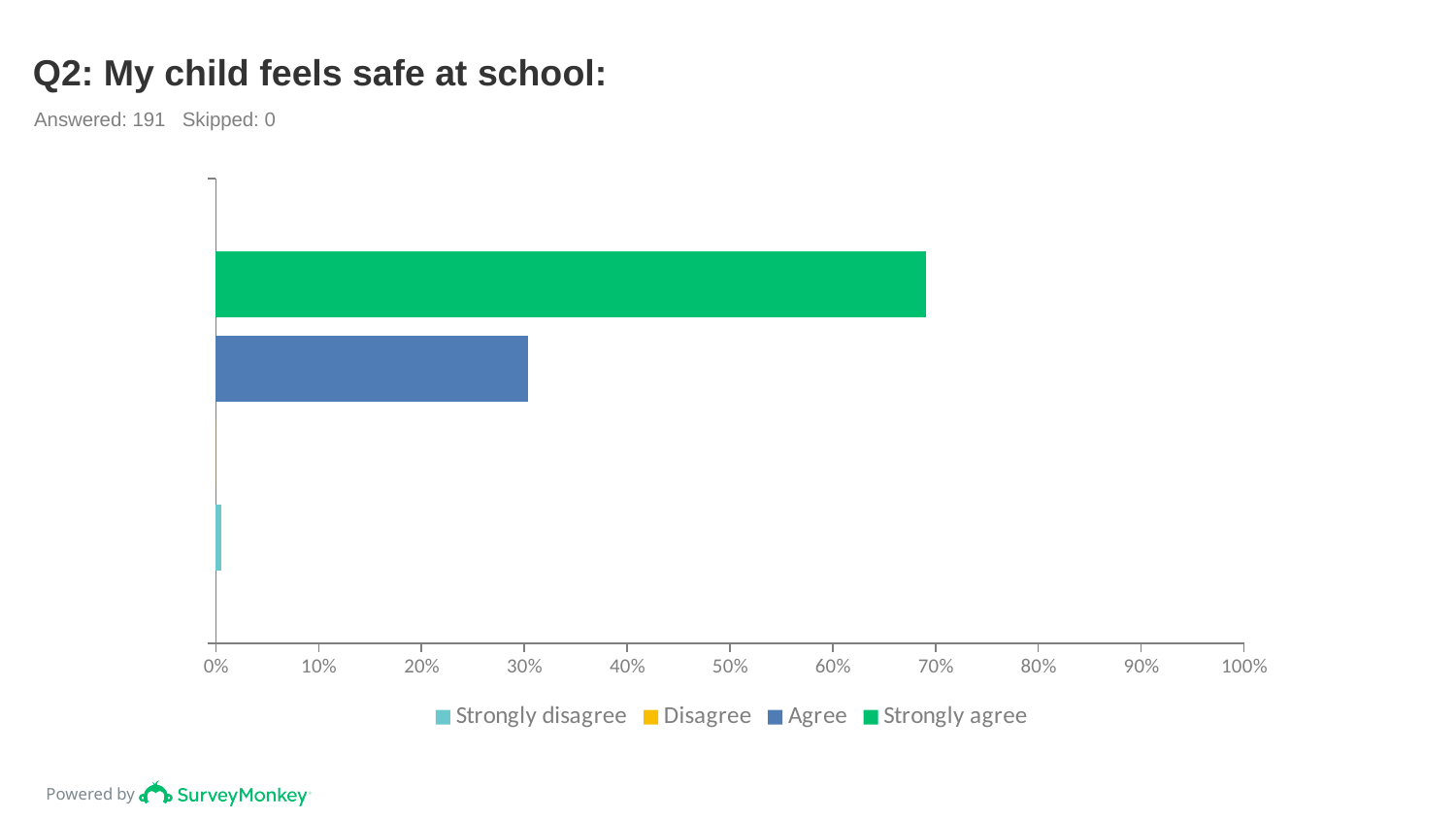
Which response option has the highest value? Strongly agree Is the value for Strongly agree greater or less than 60%? greater What kind of chart is shown on the slide? Bar chart How many series does the legend list? 4 Which is larger, the value for Agree or the value for Strongly disagree? Agree Which is larger, the value for Strongly agree or the value for Agree? Strongly agree Is the value for Agree greater or less than 20%? greater How many respondents answered the question according to the slide? 191 What is the title of the chart? Q2: My child feels safe at school: Is the value for Strongly disagree greater or less than 10%? less